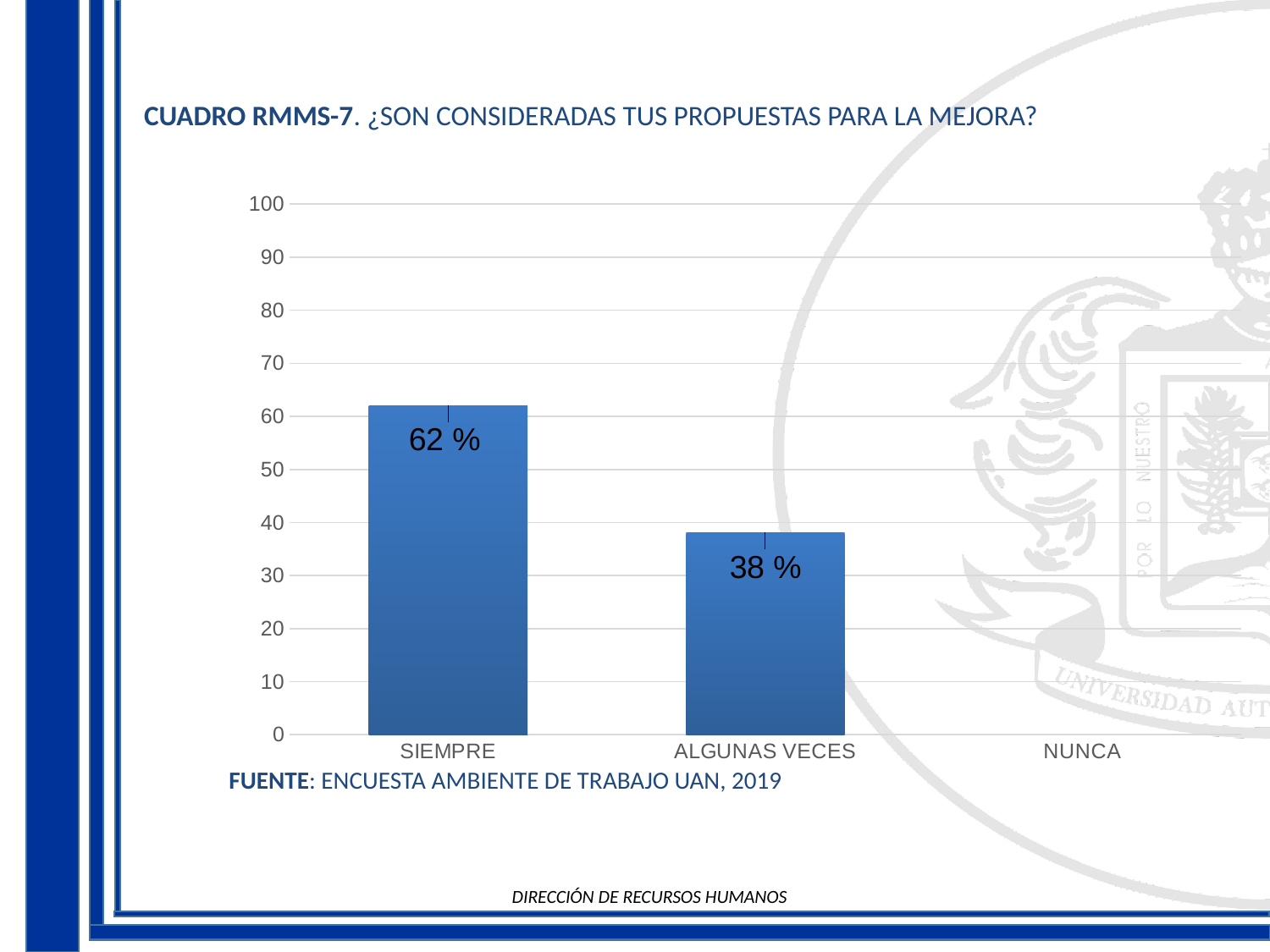
Which category has the highest value? SIEMPRE What is the value for ALGUNAS VECES? 38 % What is the source cited below the chart? ENCUESTA AMBIENTE DE TRABAJO UAN, 2019 Do the values rise or fall from SIEMPRE to ALGUNAS VECES? fall Is the value for SIEMPRE greater or less than 50? greater Which category has the lowest value among those with a visible bar? ALGUNAS VECES How many categories are shown on the x axis? 3 Is the value for ALGUNAS VECES greater or less than 40? less Which is larger, the value for SIEMPRE or the value for ALGUNAS VECES? SIEMPRE What kind of chart is shown on the slide? bar chart What is the difference between the values for SIEMPRE and ALGUNAS VECES? 24 % What is the value for SIEMPRE? 62 %